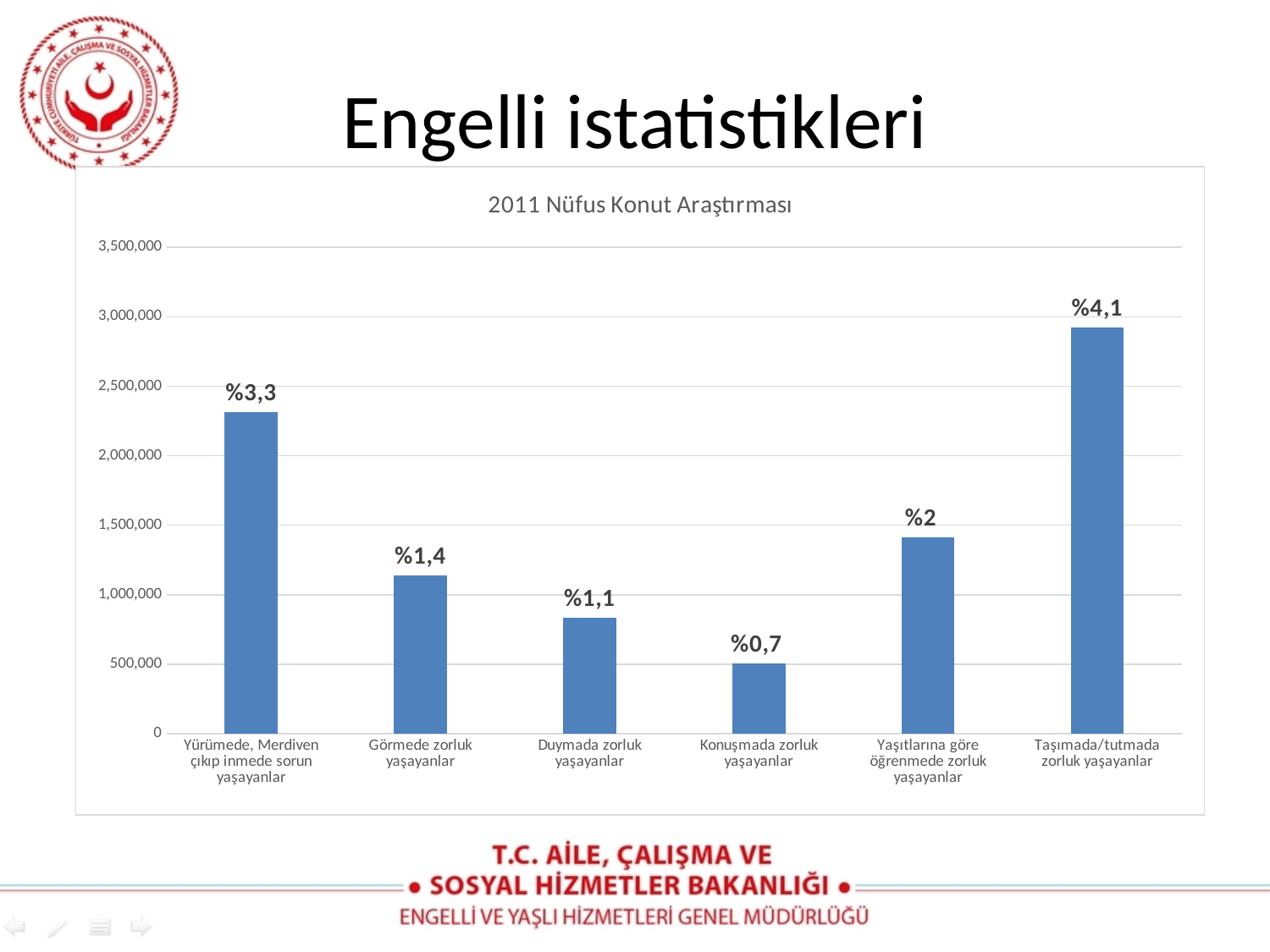
Is the value for Yürümede, Merdiven çıkıp inmede sorun yaşayanlar greater or less than 2,000,000? greater What kind of chart is shown on the slide? bar chart What percentage label is printed above the bar for Yaşıtlarına göre öğrenmede zorluk yaşayanlar? %2 What is the title of the chart? 2011 Nüfus Konut Araştırması Which bar is taller: Görmede zorluk yaşayanlar or Duymada zorluk yaşayanlar? Görmede zorluk yaşayanlar Which category has the lowest bar? Konuşmada zorluk yaşayanlar Which category has the highest bar? Taşımada/tutmada zorluk yaşayanlar What percentage label is printed above the bar for Yürümede, Merdiven çıkıp inmede sorun yaşayanlar? %3,3 Is the value for Duymada zorluk yaşayanlar greater or less than 1,000,000? less What percentage label is printed above the bar for Konuşmada zorluk yaşayanlar? %0,7 How many categories are shown in the chart? 6 Is the value for Taşımada/tutmada zorluk yaşayanlar greater or less than 2,500,000? greater